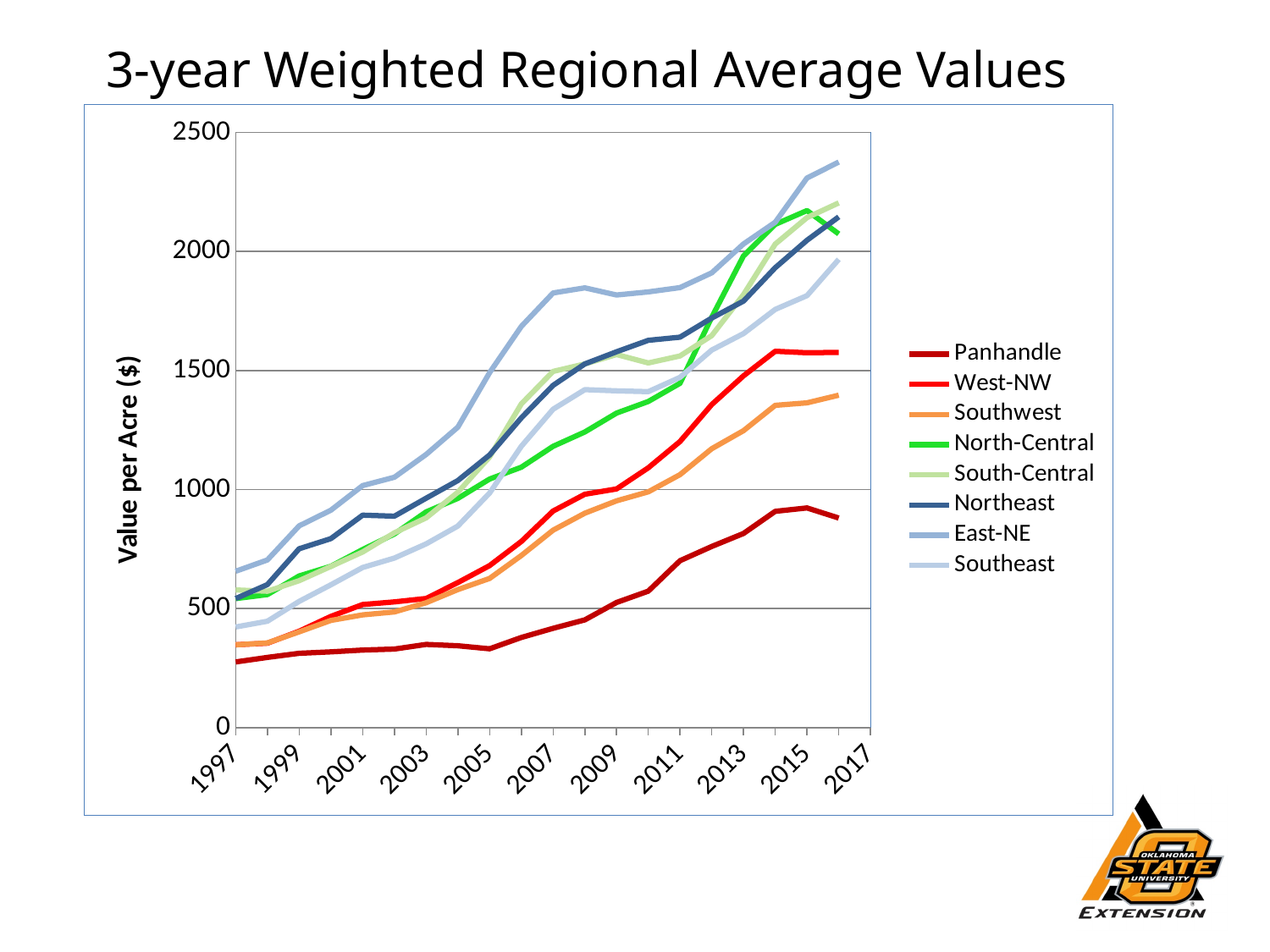
How many series does the legend list? 8 What kind of chart is shown on the slide? line chart What is the title of the chart? 3-year Weighted Regional Average Values What is the label on the vertical axis? Value per Acre ($) Does the Panhandle line generally rise or fall from 1997 to 2017? rise Is the value for Panhandle in 1997 greater or less than 500? less